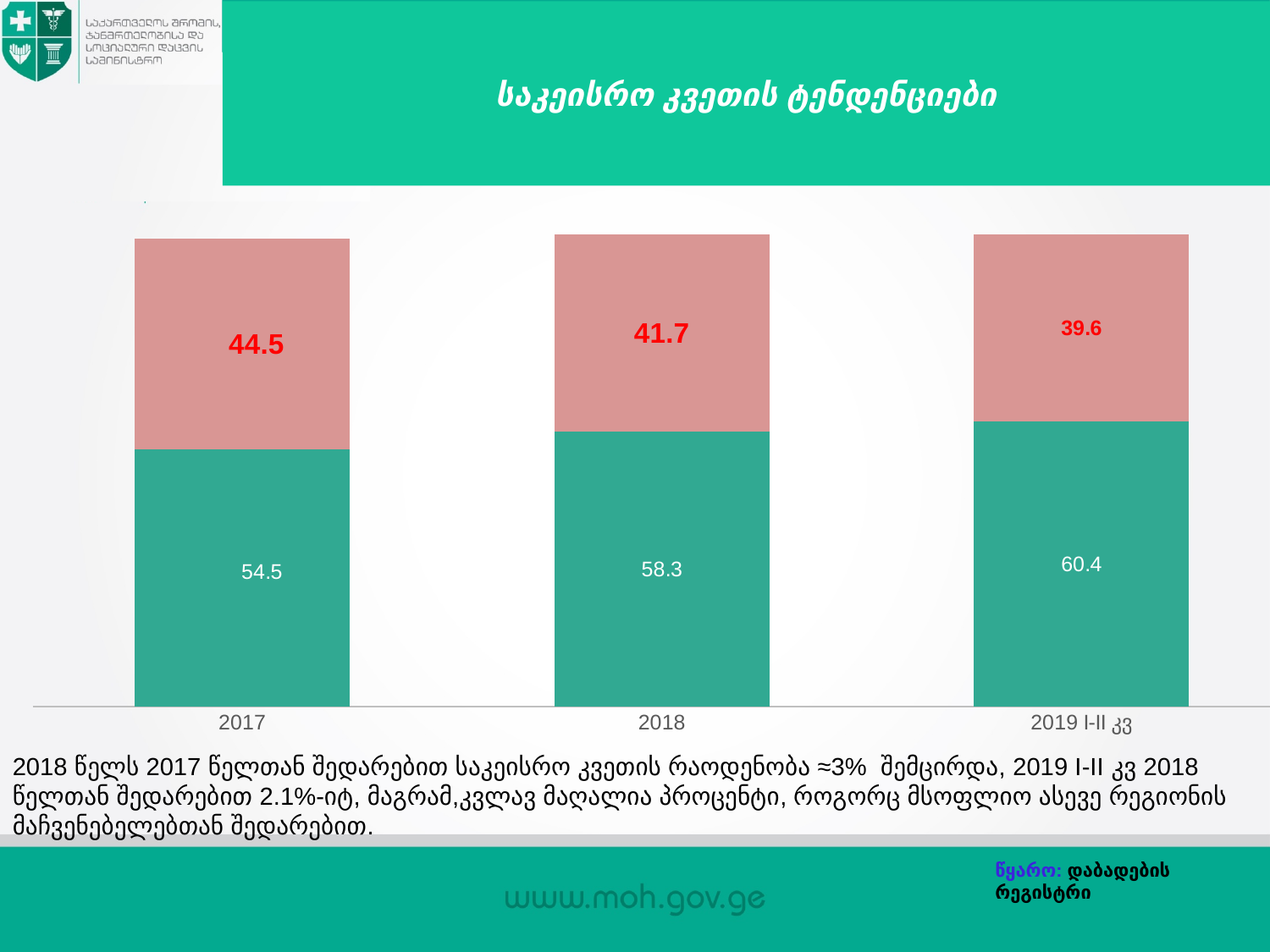
What is the value of the pink (top) segment for 2019 I-II კვ? 39.6 Which category has the highest value for the pink (top) segment? 2017 What is the value of the green (bottom) segment for 2018? 58.3 What kind of chart is shown on the slide? Stacked bar chart How many categories are shown on the x axis? 3 What is the value of the pink (top) segment for 2017? 44.5 What is the value of the green (bottom) segment for 2019 I-II კვ? 60.4 What is the total of the stacked bar for 2018? 100 What is the difference between the green segment values for 2019 I-II კვ and 2017? 5.9 Which category has the lowest value for the green (bottom) segment? 2017 Which is larger: the pink segment for 2018 or the pink segment for 2019 I-II კვ? 2018 Do the values of the pink (top) segment rise or fall from 2017 to 2019 I-II კვ? Fall